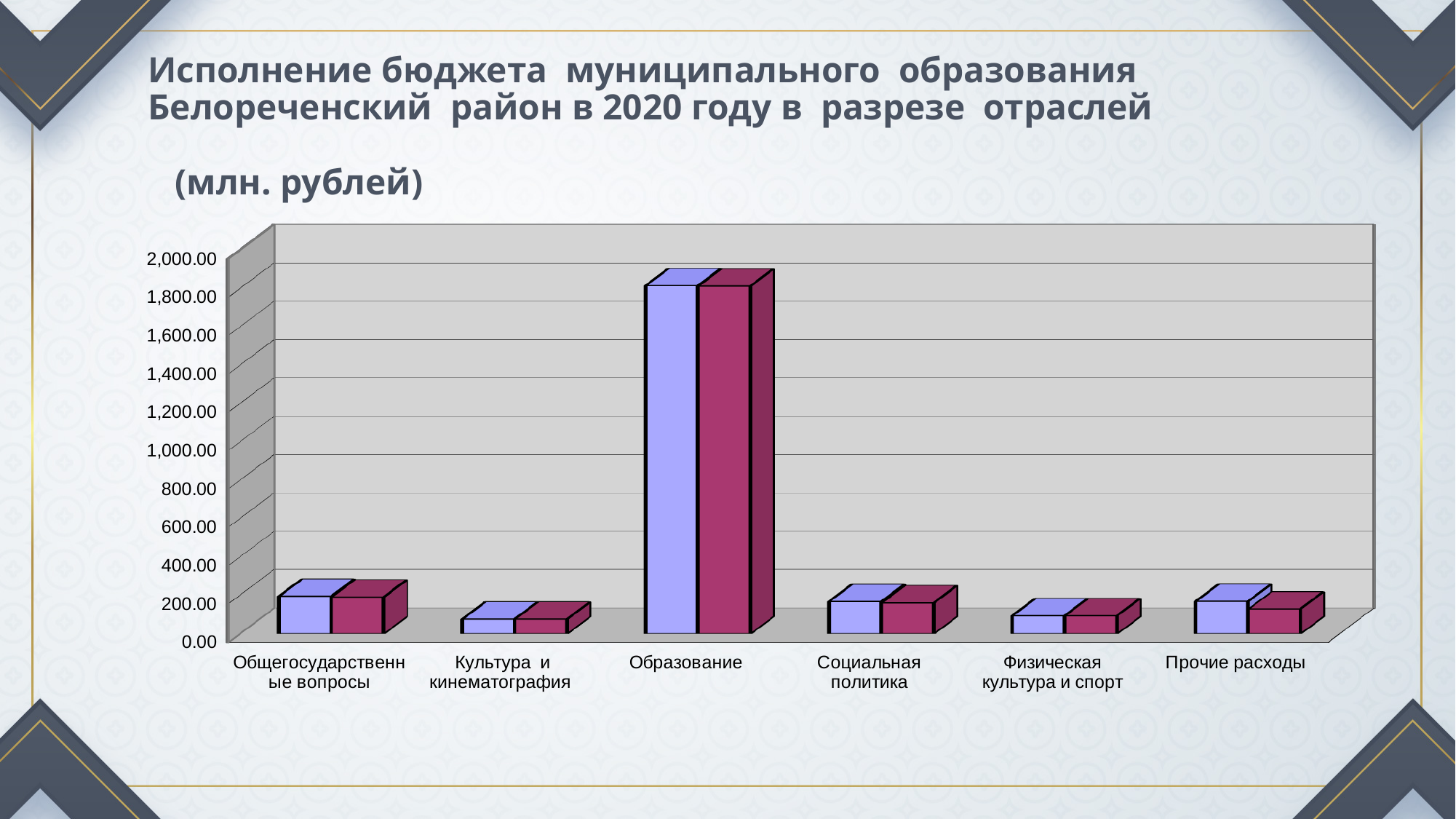
Is the value for Общегосударственные вопросы greater or less than 400.00? less Is the value for Социальная политика greater or less than 400.00? less How many bars are drawn for each category in the chart? 2 Is the value for Образование greater or less than 1,600.00? greater In what units are the values on the chart expressed, according to the slide? млн. рублей Which is larger, the value for Образование or the value for Социальная политика? Образование Which category has the highest bars in the chart? Образование What kind of chart is shown on the slide? bar chart How many categories are shown on the x axis of the chart? 6 Which is larger, the value for Общегосударственные вопросы or the value for Культура и кинематография? Общегосударственные вопросы